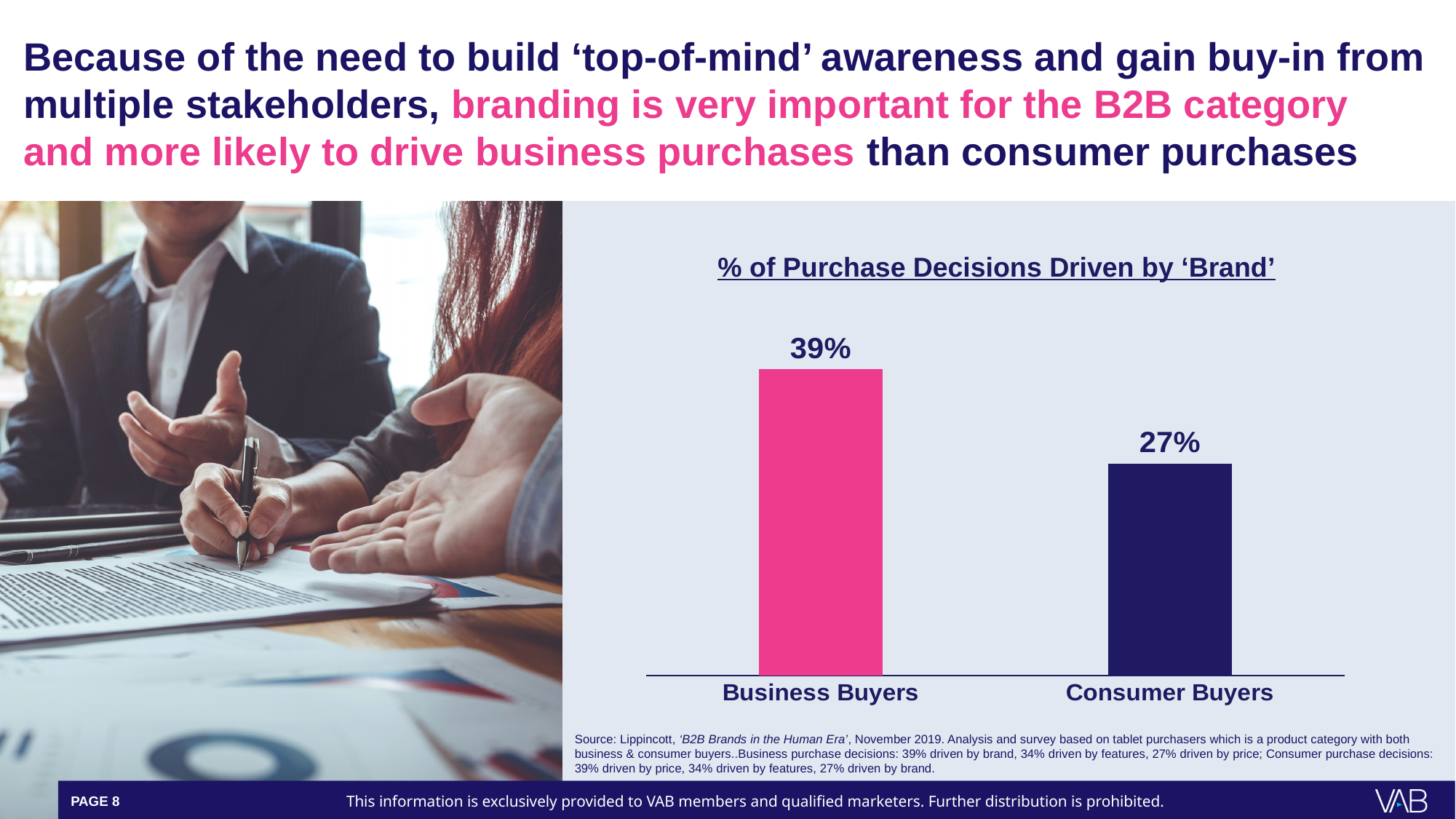
What percentage of purchase decisions are driven by 'Brand' for Consumer Buyers? 27% What is the difference in percentage points between Business Buyers and Consumer Buyers? 12 percentage points How many categories are shown in the chart? 2 What percentage of purchase decisions are driven by 'Brand' for Business Buyers? 39% What colour is the bar for Business Buyers? pink Which category has the higher percentage of purchase decisions driven by 'Brand'? Business Buyers What is the title of the chart? % of Purchase Decisions Driven by 'Brand' Is the value for Business Buyers larger or smaller than the value for Consumer Buyers? larger Do the values fall or rise from Business Buyers to Consumer Buyers? fall Which category has the lower percentage of purchase decisions driven by 'Brand'? Consumer Buyers What kind of chart is shown on the slide? bar chart